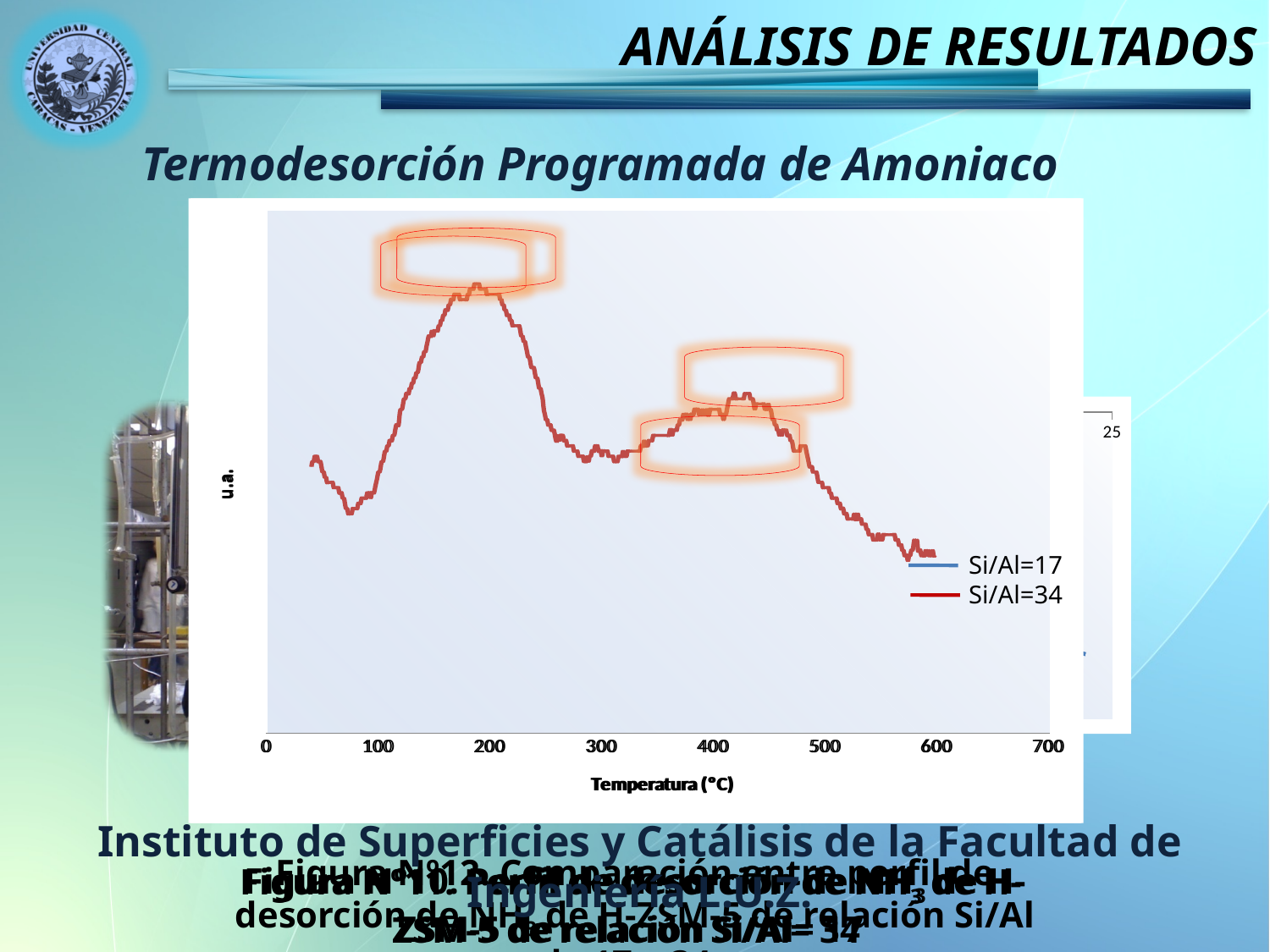
Is the temperature at which the Si/Al=34 curve reaches its lowest point (the dip before the first peak) greater or less than 100? less Is the temperature at which the Si/Al=34 curve reaches its highest point greater or less than 300? less Does the Si/Al=34 curve rise or fall between 200 and 300 on the x axis? fall How many series does the chart legend list? 2 Is the temperature of the second (smaller) peak of the Si/Al=34 curve greater or less than 300? greater What are the two series named in the chart legend? Si/Al=17 and Si/Al=34 What is the highest value labelled on the x axis of the chart? 700 What kind of chart is shown on the slide? line chart Does the Si/Al=34 curve rise or fall between 100 and 200 on the x axis? rise Which peak of the Si/Al=34 curve is higher: the one below 300 °C or the one above 300 °C? the one below 300 °C What is the title of the x axis of the chart? Temperatura (°C) Does the Si/Al=34 curve rise or fall between 500 and 600 on the x axis? fall